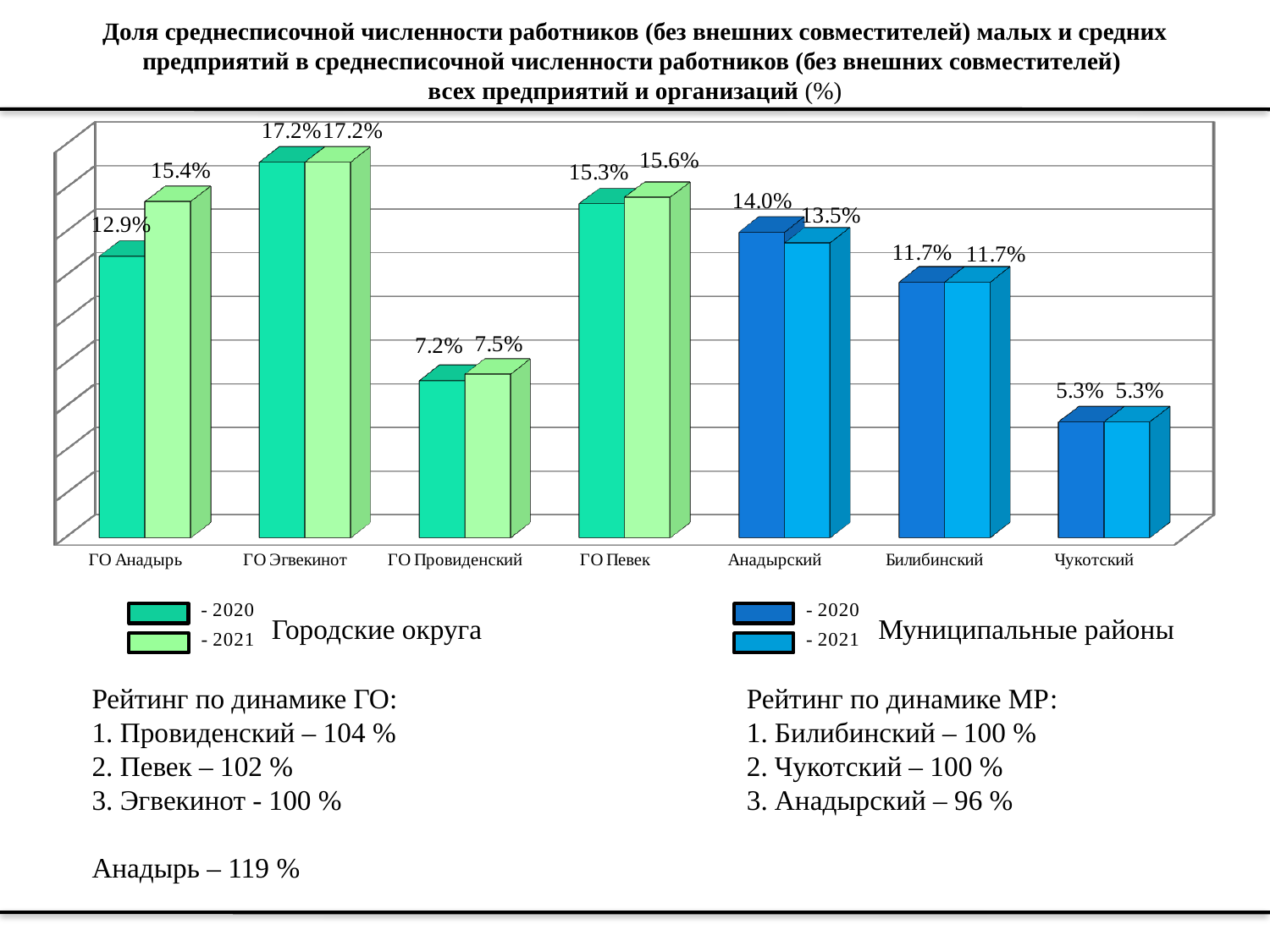
What kind of chart is shown on the slide? Bar chart What is the 2020 value for Анадырский? 14.0% Which category has the lowest value in 2020? Чукотский Which two years does the chart legend list? 2020 and 2021 What is the 2020 value for Билибинский? 11.7% Which category has the highest value in 2021? ГО Эгвекинот Which is larger, the 2021 value for ГО Певек or the 2021 value for Анадырский? ГО Певек What is the difference between the 2021 and 2020 values for ГО Анадырь? 2.5% What is the 2021 value for ГО Анадырь? 15.4% What is the difference between the 2020 and 2021 values for Анадырский? 0.5% How many categories are shown on the x axis of the chart? 7 What is the 2021 value for ГО Провиденский? 7.5%